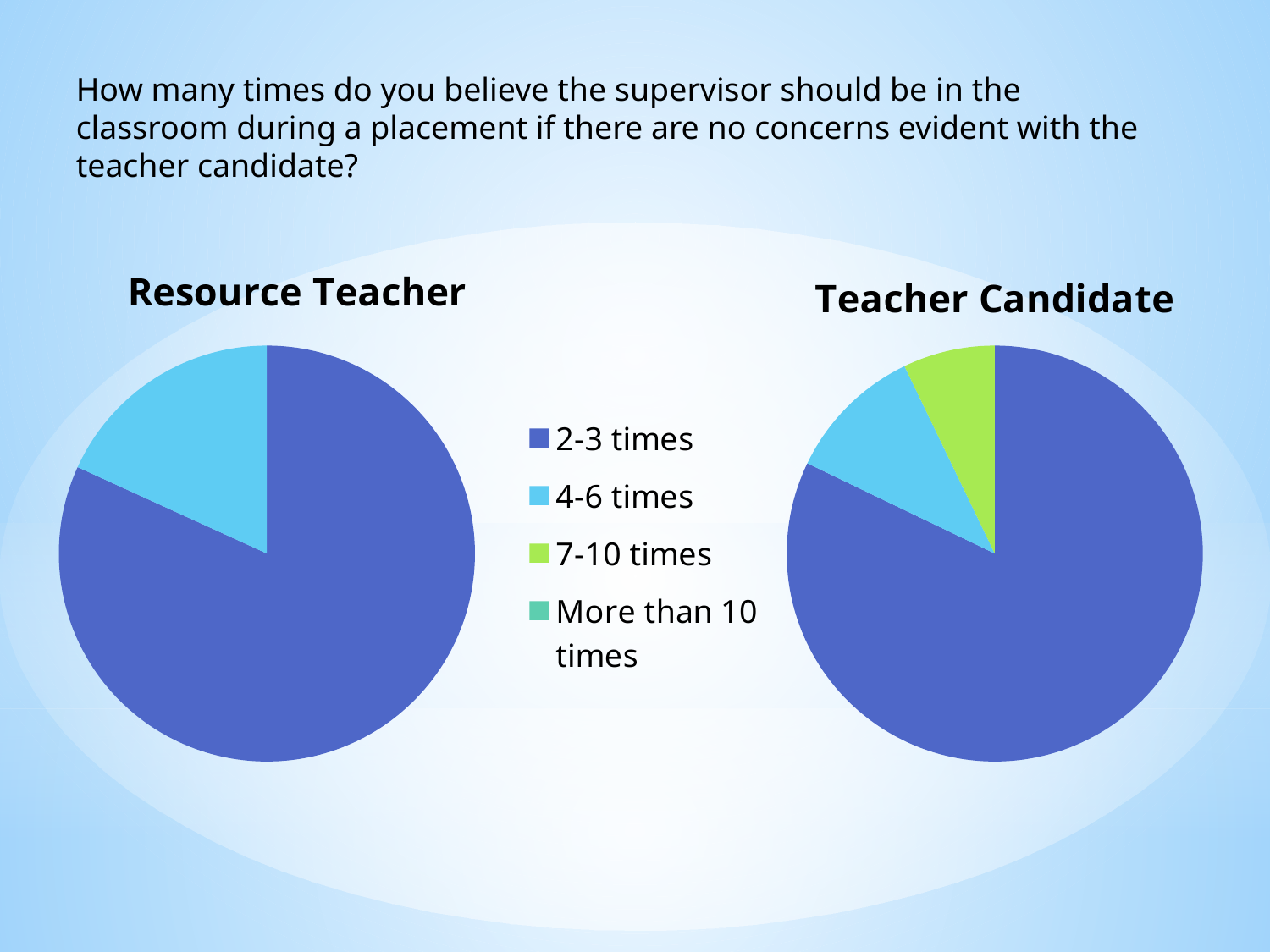
In the Teacher Candidate chart, which of the visible slices is the smallest? 7-10 times How many slices are visible in the Teacher Candidate pie chart? 3 How many categories does the legend list? 4 What is the title of the pie chart on the left? Resource Teacher What kind of chart is the Teacher Candidate chart? pie chart In the Teacher Candidate chart, which slice is larger: 4-6 times or 7-10 times? 4-6 times In the Resource Teacher chart, which category has the largest slice? 2-3 times Which legend category is shown in green? 7-10 times What kind of chart is the Resource Teacher chart? pie chart How many slices are visible in the Resource Teacher pie chart? 2 In the Resource Teacher chart, which slice is larger: 2-3 times or 4-6 times? 2-3 times In the Teacher Candidate chart, which category has the largest slice? 2-3 times